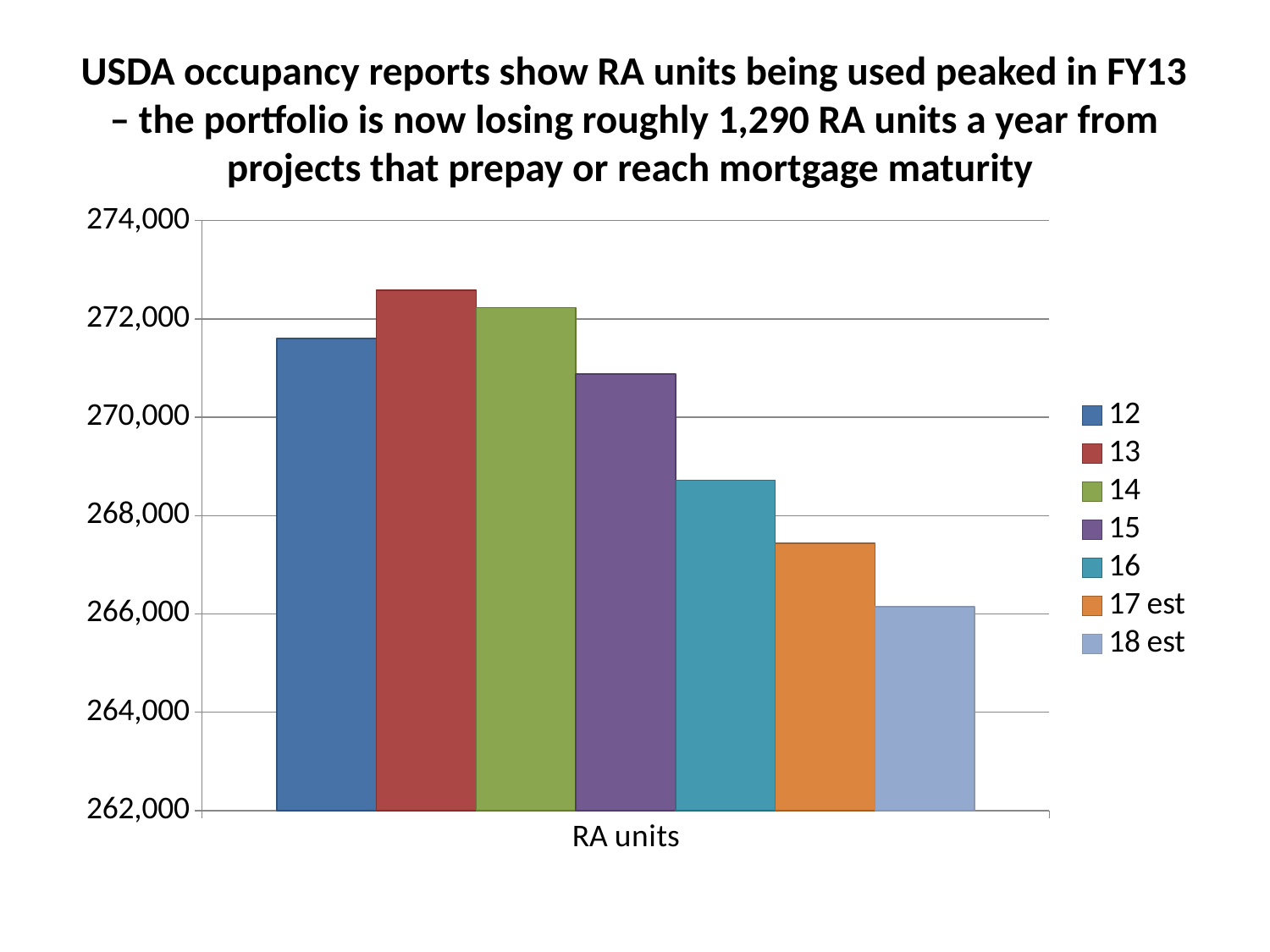
Is the value for 15 greater or less than 272,000? less Which is larger, the value for 12 or the value for 15? 12 Which series has the highest value for RA units? 13 Do the values rise or fall from series 13 through 18 est? fall Which series has the lowest value for RA units? 18 est Is the value for 12 greater or less than 270,000? greater Is the value for 16 greater or less than 268,000? greater Which is larger, the value for 16 or the value for 17 est? 16 What is the label shown on the x axis of the chart? RA units What kind of chart is shown on the slide? bar chart How many series does the legend list? 7